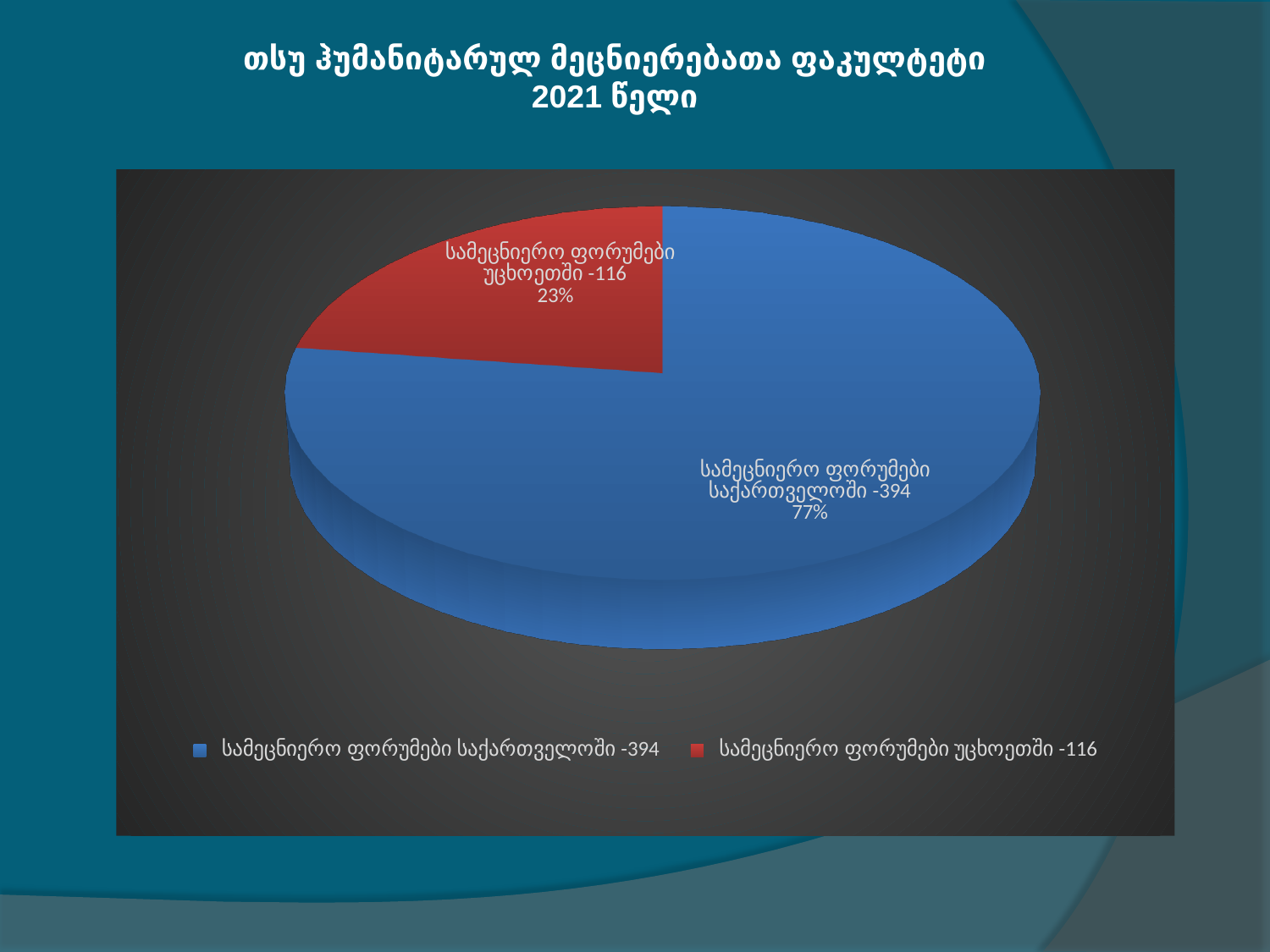
What is the total number of scientific forums across both slices? 510 What is the number of scientific forums in Georgia (საქართველოში) shown in the chart? 394 How many entries does the legend list? 2 Which slice is the largest in the pie chart? სამეცნიერო ფორუმები საქართველოში -394 What percentage share does the slice "სამეცნიერო ფორუმები საქართველოში" (scientific forums in Georgia) have? 77% What is the difference between the number of scientific forums in Georgia (394) and abroad (116)? 278 What colour is the slice for scientific forums abroad (უცხოეთში)? red Which slice is the smallest in the pie chart? სამეცნიერო ფორუმები უცხოეთში -116 What is the number of scientific forums abroad (უცხოეთში) shown in the chart? 116 What percentage share does the slice "სამეცნიერო ფორუმები უცხოეთში" (scientific forums abroad) have? 23% What kind of chart is shown on the slide? pie chart How many slices does the pie chart have? 2